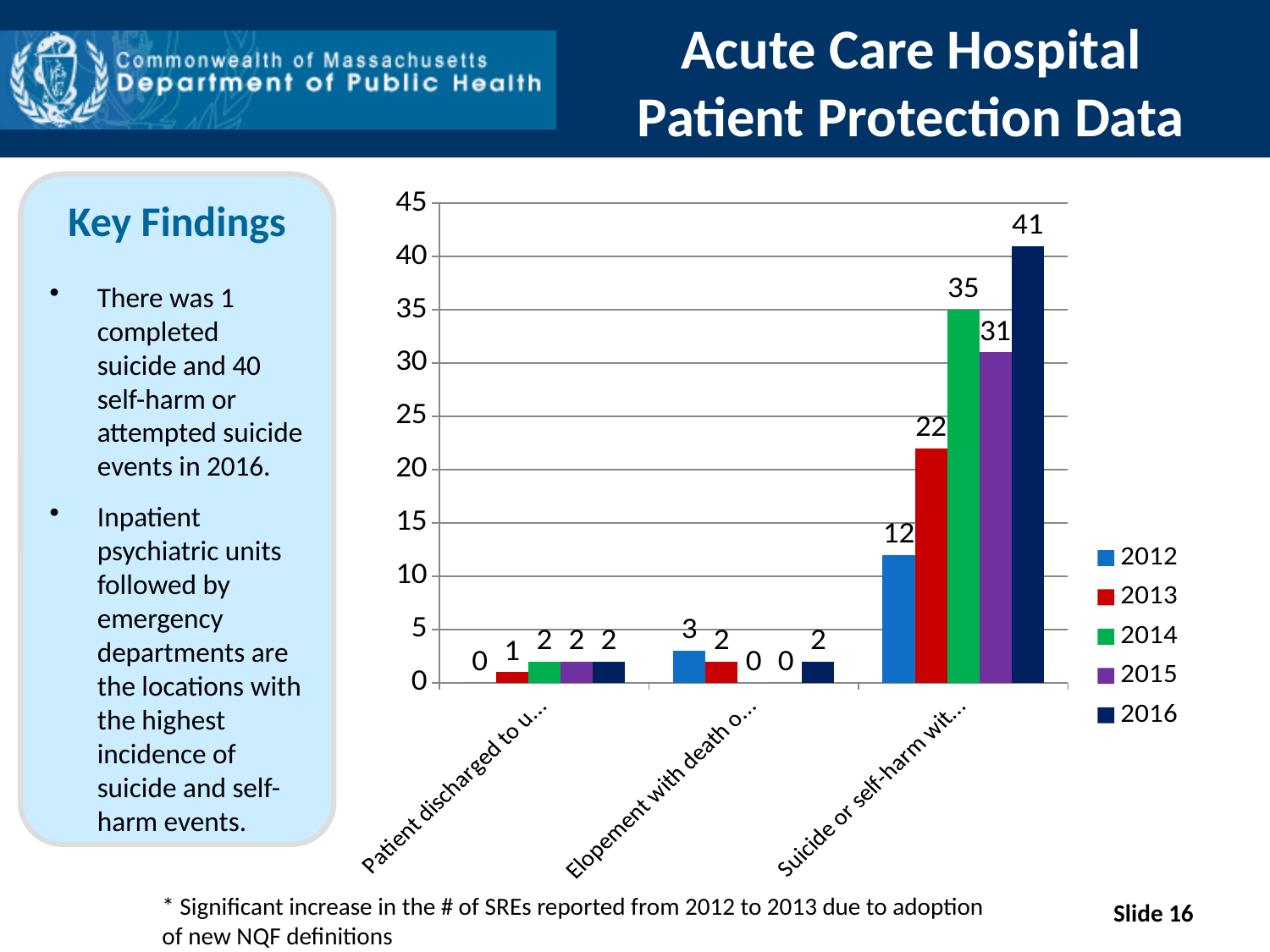
What is the difference between the 2016 and 2015 values in the 'Suicide or self-harm' category? 10 Which year has the lowest value in the 'Suicide or self-harm' category? 2012 What is the 2014 value for the 'Suicide or self-harm' category? 35 How many categories are shown on the x axis of the chart? 3 Which year has the highest value in the 'Suicide or self-harm' category? 2016 In the 'Suicide or self-harm' category, which is larger, the 2014 value or the 2015 value? 2014 How many series does the chart legend list? 5 What is the 2012 value for the 'Elopement with death' category? 3 Which series is shown in green in the chart legend? 2014 What is the 2016 value for the 'Suicide or self-harm' category? 41 What type of chart is shown on the slide? bar chart What is the 2013 value for the 'Patient discharged' category? 1